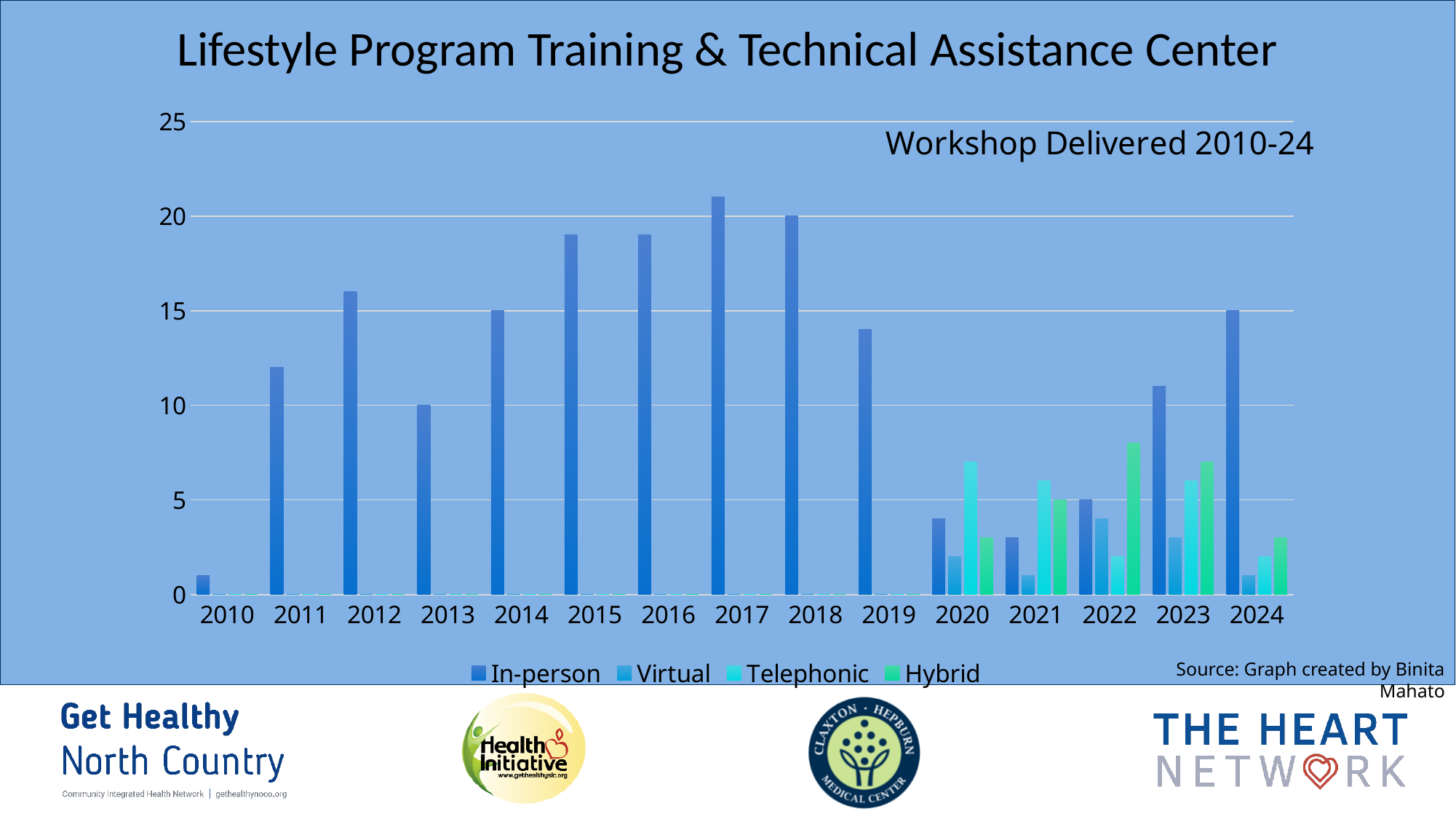
What is the In-person value for 2013? 10 Is the In-person value for 2017 greater or less than 20? greater Is the Hybrid value for 2022 greater or less than 5? greater How many years are shown on the x axis? 15 What is the In-person value for 2018? 20 Is the In-person value for 2012 greater or less than 15? greater Which is larger, the In-person value for 2015 or the In-person value for 2019? 2015 What is the subtitle shown inside the chart area? Workshop Delivered 2010-24 Which year has the highest In-person value? 2017 What kind of chart is shown on the slide? bar chart Which year has the lowest In-person value? 2010 How many series does the legend list? 4